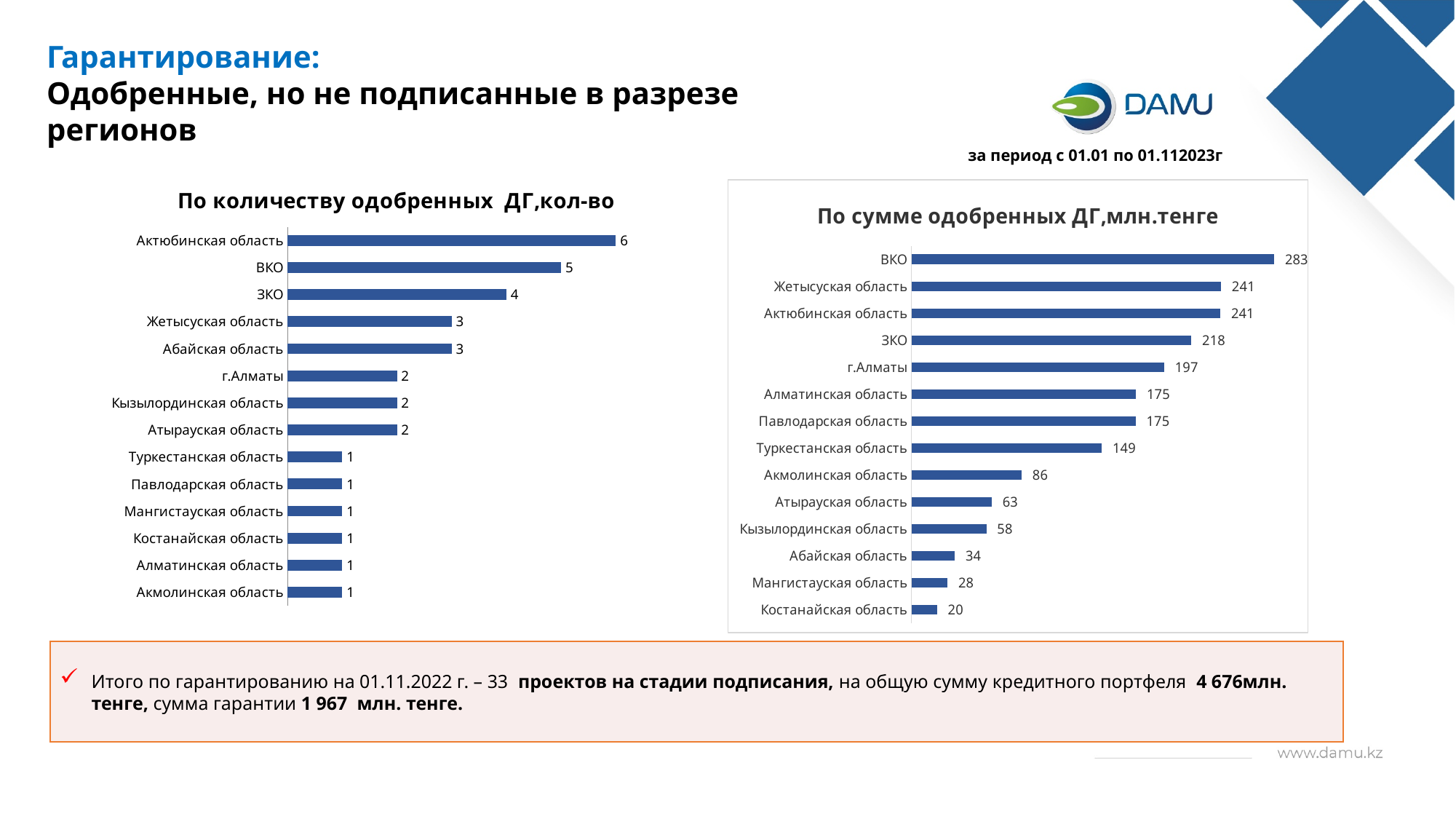
In the chart 'По сумме одобренных ДГ,млн.тенге', what is the value for Туркестанская область? 149 In the chart 'По количеству одобренных ДГ,кол-во', which region has the highest value? Актюбинская область In the chart 'По количеству одобренных ДГ,кол-во', how many regions are shown? 14 In the chart 'По сумме одобренных ДГ,млн.тенге', what is the difference between ВКО and ЗКО? 65 In the chart 'По количеству одобренных ДГ,кол-во', what is the value for ЗКО? 4 What type of chart is 'По количеству одобренных ДГ,кол-во'? Bar chart In the chart 'По сумме одобренных ДГ,млн.тенге', which region has the lowest value? Костанайская область In the chart 'По сумме одобренных ДГ,млн.тенге', which region has the highest value? ВКО In the chart 'По сумме одобренных ДГ,млн.тенге', what is the value for г.Алматы? 197 What is the title of the chart on the right side of the slide? По сумме одобренных ДГ,млн.тенге In the chart 'По сумме одобренных ДГ,млн.тенге', which is larger: Акмолинская область or Атырауская область? Акмолинская область In the chart 'По количеству одобренных ДГ,кол-во', what is the difference between ВКО and Жетысуская область? 2